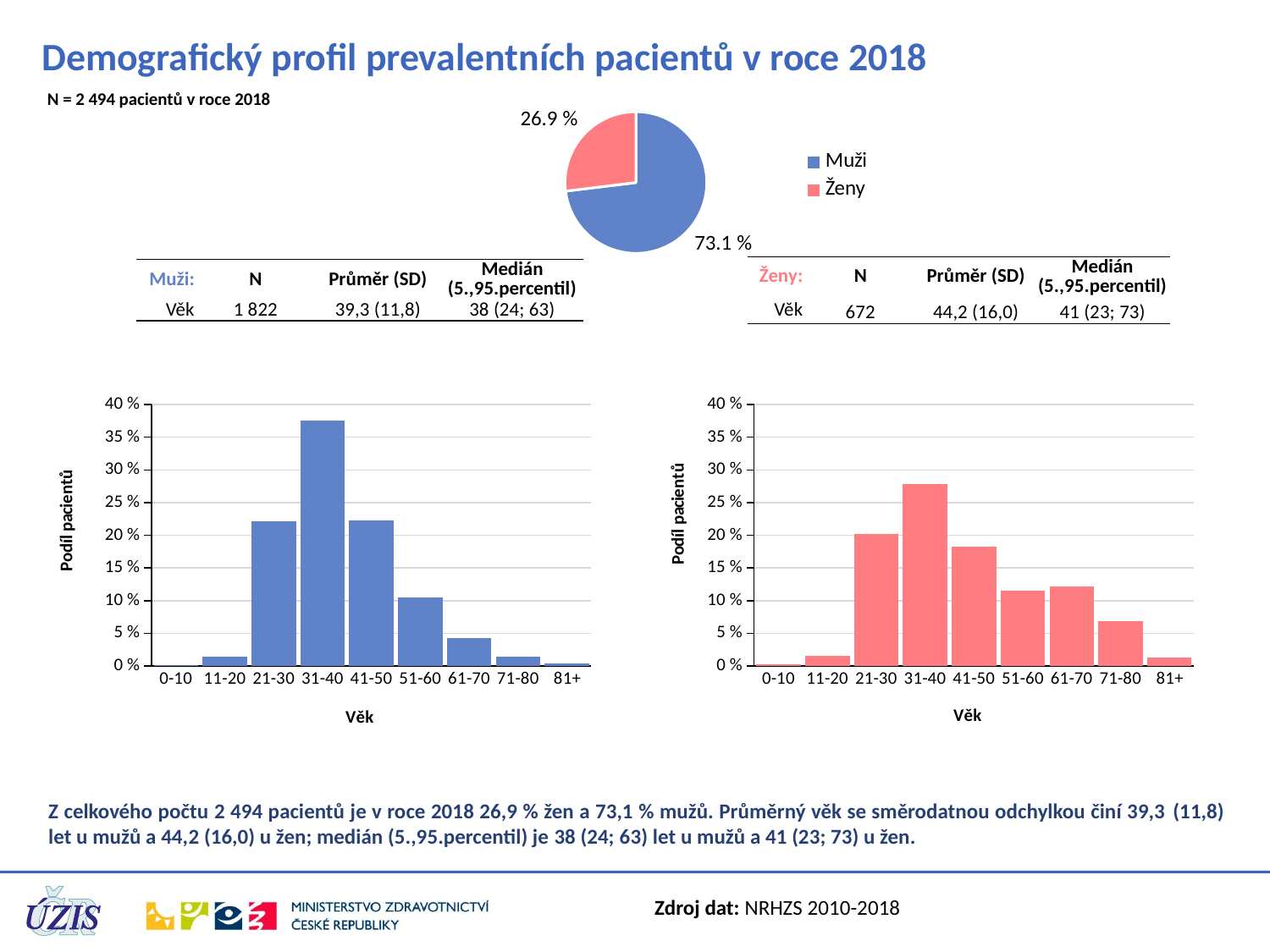
What type of chart is used to show the age distribution of men (bottom left)? bar chart In the left bar chart (men), is the value for the 31-40 age group greater or less than 35 %? greater In the right bar chart (women), is the value for the 71-80 age group greater or less than 10 %? less In the right bar chart (women), is the value for the 31-40 age group greater or less than 25 %? greater How many entries does the legend of the pie chart list? 2 In the left bar chart (men, blue), which age group has the highest share of patients? 31-40 How many age categories are shown on the x axis of the left bar chart (men)? 9 In the pie chart, what share of patients are Ženy (women)? 26.9 % In the pie chart, which group has the larger share, Muži or Ženy? Muži In the left bar chart (men), do the values rise or fall from the 31-40 age group to the 81+ age group? fall In the right bar chart (women, pink), which age group has the highest share of patients? 31-40 In the pie chart, what share of patients are Muži (men)? 73.1 %